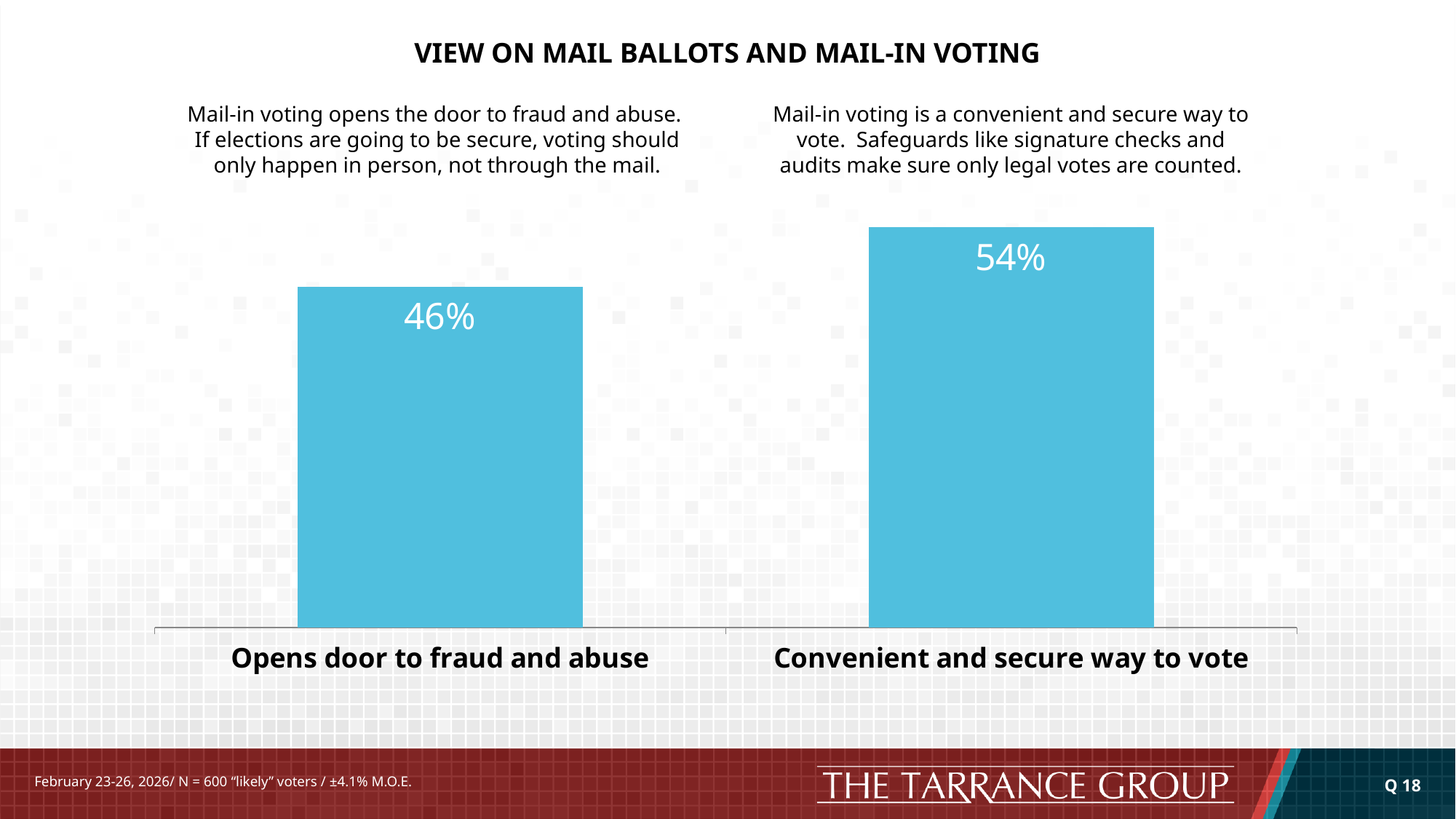
What is the total of the two values shown in the chart? 100% What is the difference between the values for "Convenient and secure way to vote" and "Opens door to fraud and abuse"? 8% Which category has the highest value? Convenient and secure way to vote What is the value for "Opens door to fraud and abuse"? 46% Which is larger: the value for "Opens door to fraud and abuse" or the value for "Convenient and secure way to vote"? Convenient and secure way to vote What kind of chart is shown on the slide? Bar chart How many categories are shown in the chart? 2 What is the title of the chart? VIEW ON MAIL BALLOTS AND MAIL-IN VOTING Which category has the lowest value? Opens door to fraud and abuse What colour are the bars in the chart? Light blue What is the value for "Convenient and secure way to vote"? 54%